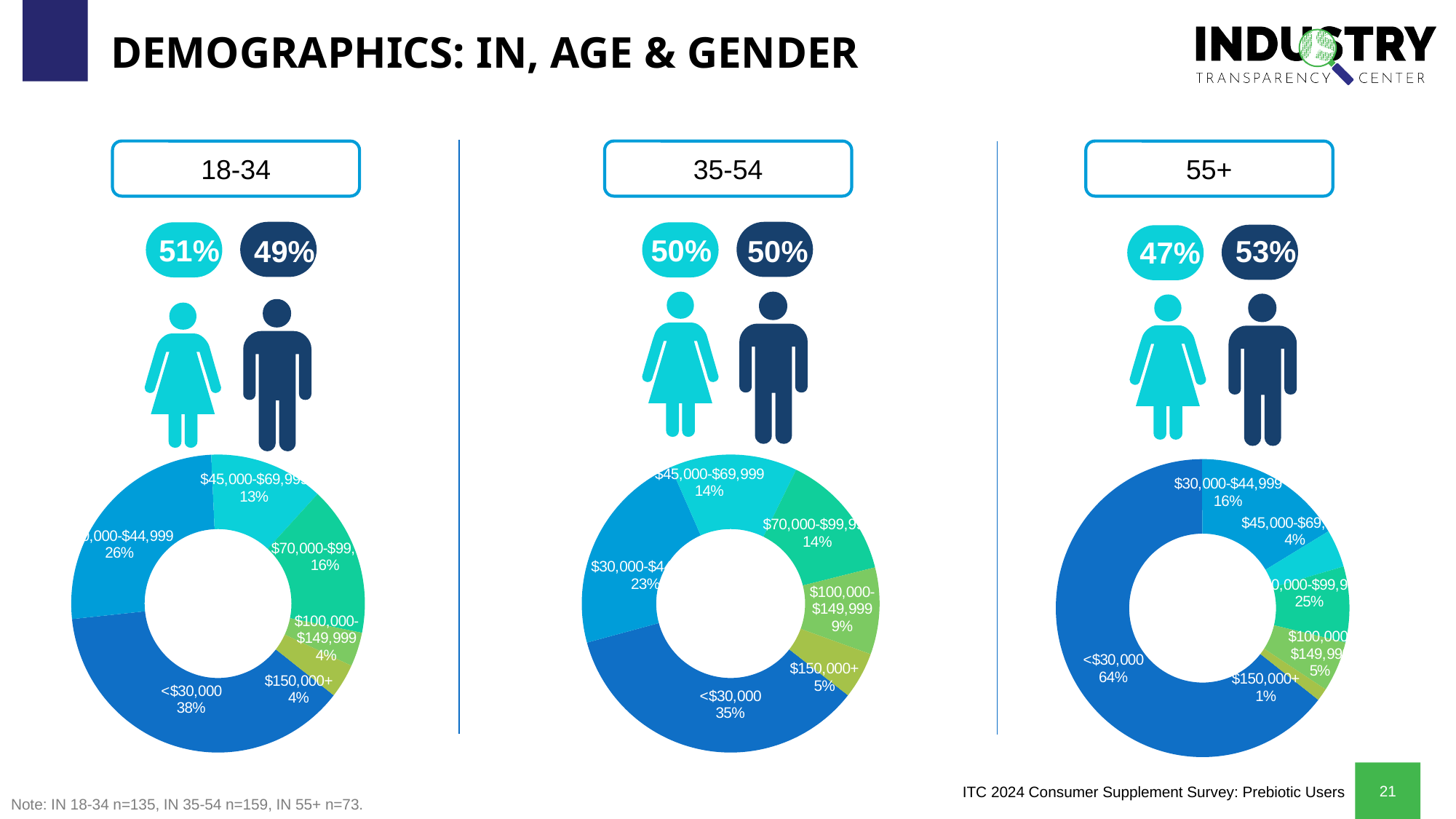
How many income brackets are shown in the 35-54 donut chart? 6 In the 18-34 donut chart, what share of respondents have income under $30,000? 38% What type of chart is used to show income distribution for each age group? Donut (pie) chart In the 55+ donut chart, what share of respondents have income under $30,000? 64% What is the male share shown for the 18-34 age group? 49% In the 55+ donut chart, which income bracket has the smallest share? $150,000+ In the 18-34 donut chart, what share of respondents are in the $70,000-$99,999 bracket? 16% In the 35-54 donut chart, which income bracket has the largest share? <$30,000 What percentage of the 55+ group is female according to the slide? 47% In the 35-54 donut chart, what share of respondents fall in the $100,000-$149,999 income bracket? 9% In the 18-34 donut chart, what is the difference between the <$30,000 share and the $30,000-$44,999 share? 12 percentage points